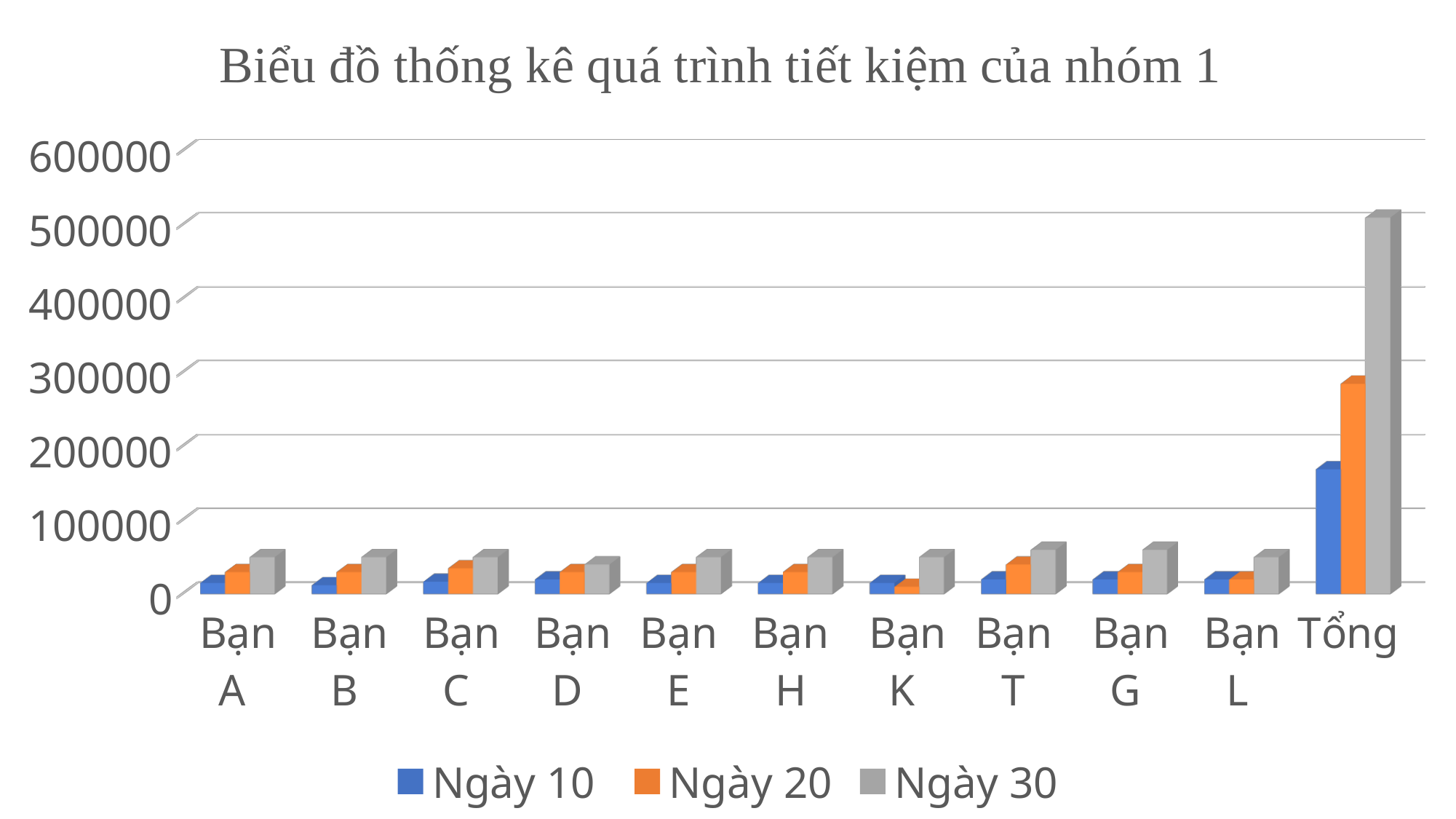
Which category has the highest value for the Ngày 30 series? Tổng For Tổng, which is larger: the Ngày 10 value or the Ngày 30 value? Ngày 30 Is the Ngày 10 value for Tổng greater or less than 100000? greater What kind of chart is shown on the slide? Bar chart Is the Ngày 30 value for Bạn A greater or less than 100000? less Which category has the lowest value for the Ngày 20 series? Bạn K How many series does the legend list? 3 What is the title of the chart? Biểu đồ thống kê quá trình tiết kiệm của nhóm 1 How many categories are shown on the x axis? 11 Is the Ngày 30 value for Tổng greater or less than 400000? greater Which series is shown in orange according to the legend? Ngày 20